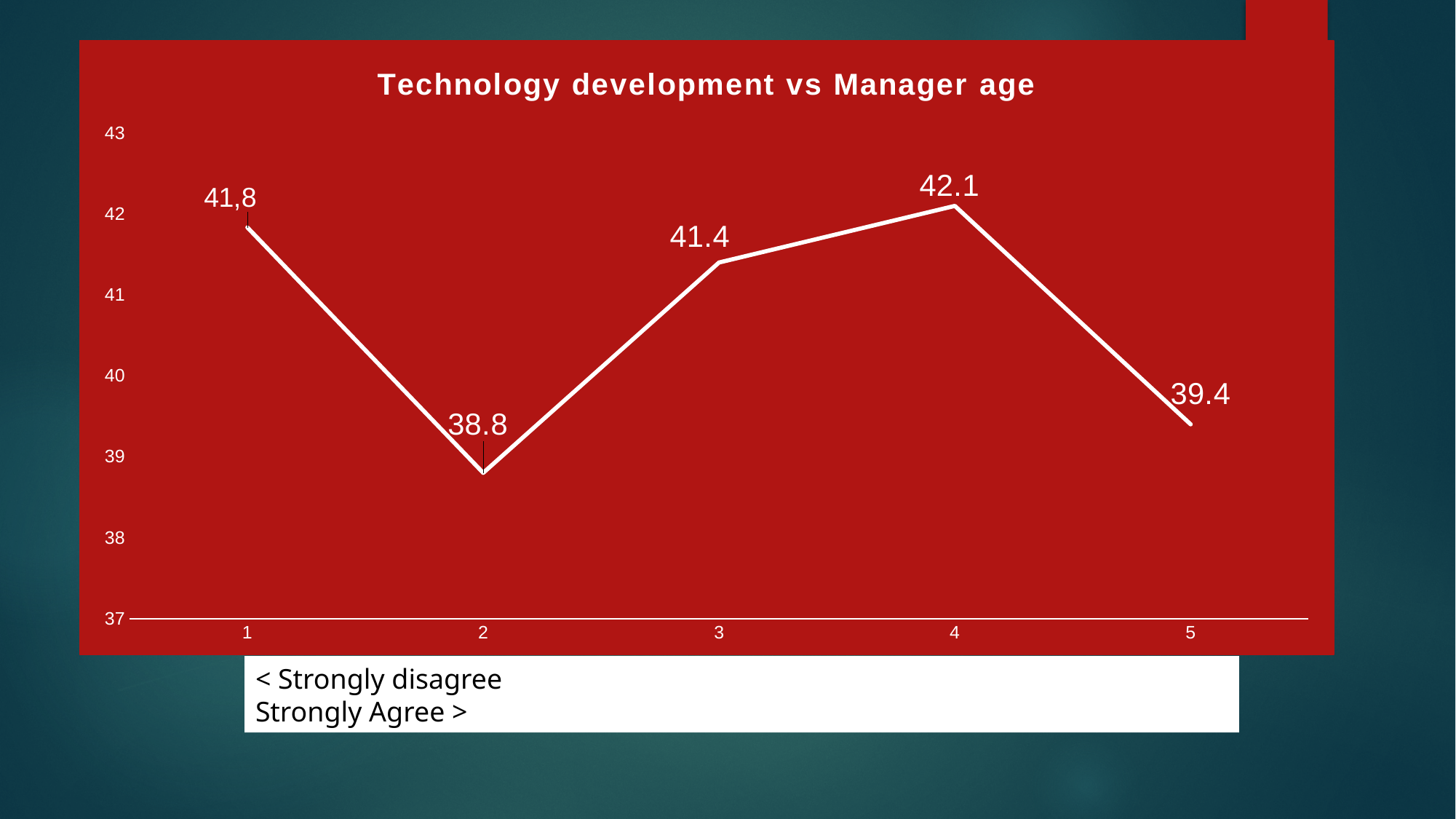
How many data points are plotted on the line? 5 What is the value at category 2? 38.8 Does the value rise or fall from category 4 to category 5? fall What is the value at category 4? 42.1 What is the difference between the values at category 4 and category 2? 3.3 What is the value at category 5? 39.4 Which is larger, the value at category 3 or the value at category 5? category 3 Which category has the highest value? 4 What is the value at category 1? 41,8 What type of chart is shown on the slide? line chart Which category has the lowest value? 2 What is the title of the chart? Technology development vs Manager age